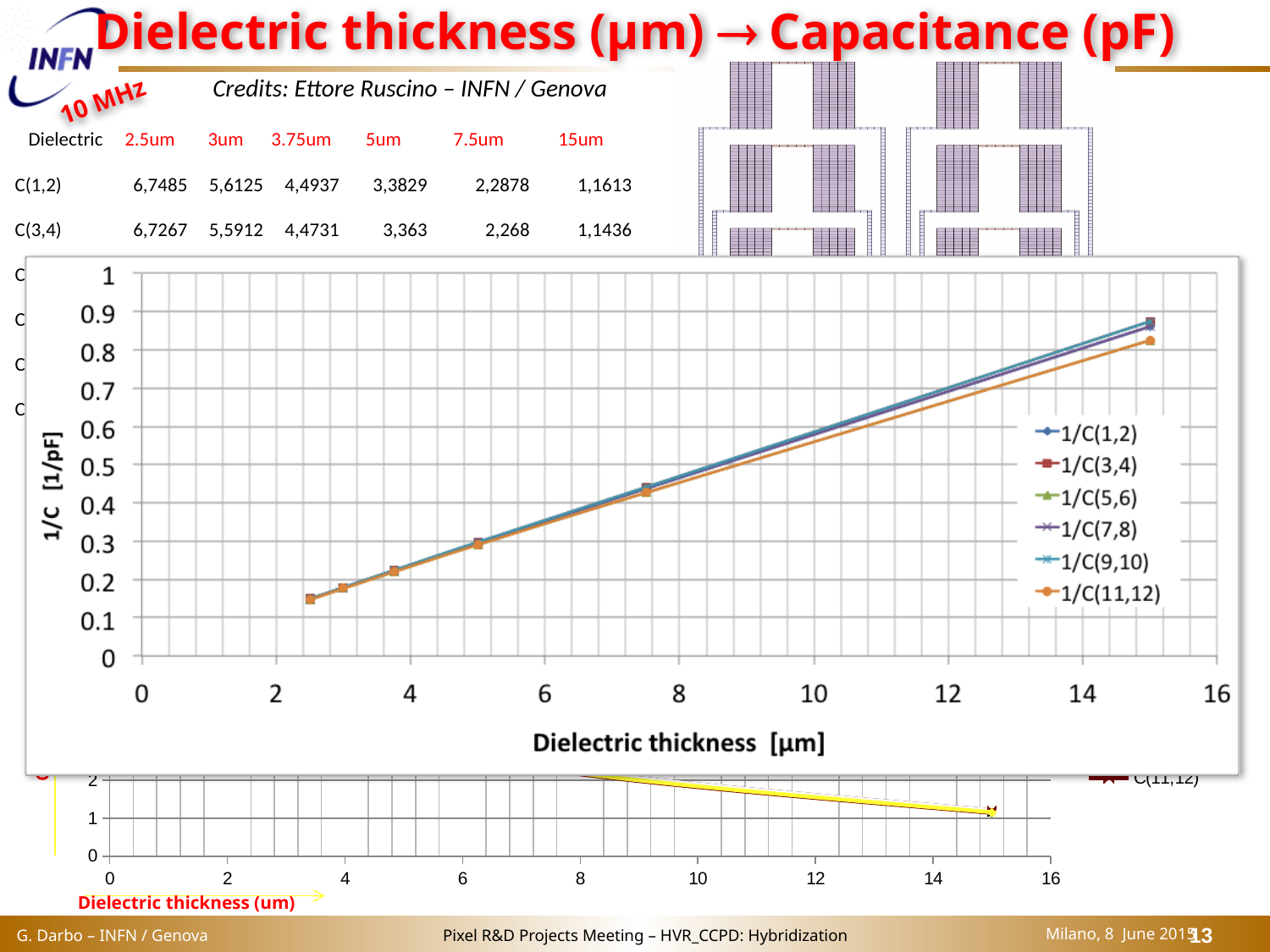
How many data points does each series in the 1/C chart have? 6 In the 1/C chart, which series has the lowest value at 15 µm? 1/C(11,12) In the 1/C chart, do the values rise or fall as dielectric thickness increases? rise What is the highest tick value shown on the x-axis of the 1/C chart? 16 How many series does the legend of the 1/C chart list? 6 What is the x-axis title of the 1/C chart? Dielectric thickness [µm] What is the y-axis title of the 1/C chart? 1/C [1/pF] In the 1/C chart, at 15 µm, is the value of 1/C(1,2) larger or smaller than the value of 1/C(11,12)? larger In the 1/C chart, is the value of 1/C(11,12) at 7.5 µm greater or less than 0.4? greater In the 1/C chart, is the value of 1/C(1,2) at 15 µm greater or less than 0.8? greater What kind of chart is the main chart showing 1/C versus dielectric thickness? line chart In the 1/C chart, is the value of 1/C(1,2) at 2.5 µm greater or less than 0.2? less